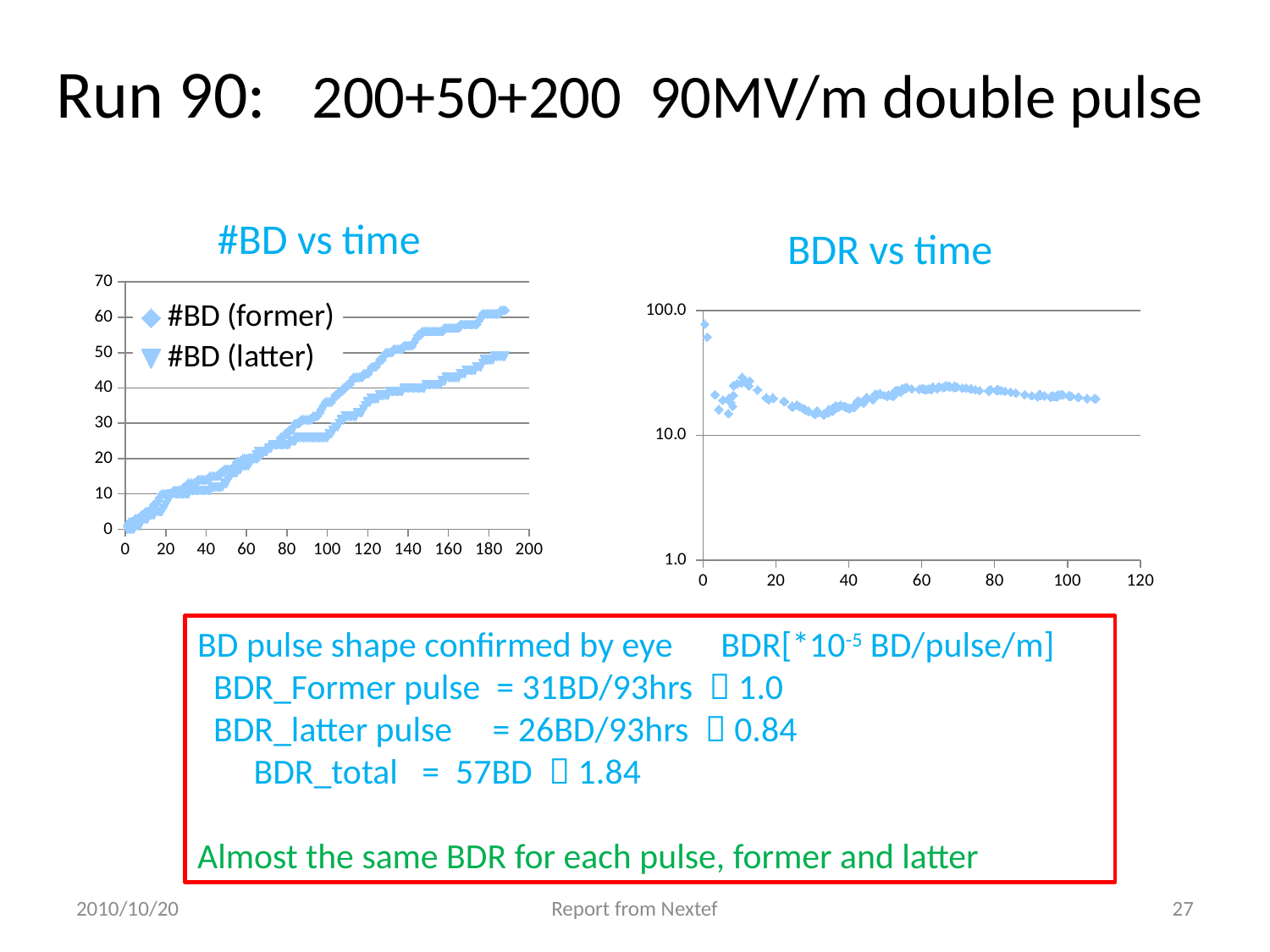
In the '#BD vs time' chart, is the value of #BD (latter) at x = 100 greater or less than 30? less In the '#BD vs time' chart, how many series does the legend list? 2 In the '#BD vs time' chart, at x = 180, which series has the larger value, #BD (former) or #BD (latter)? #BD (former) In the '#BD vs time' chart, do the #BD values rise or fall as time increases along the x axis? rise In the 'BDR vs time' chart, is the value at x = 100 greater or less than 10.0? greater What kind of chart is the 'BDR vs time' chart? scatter chart What kind of chart is the '#BD vs time' chart? scatter chart In the '#BD vs time' chart, what is the maximum value shown on the y axis? 70 In the 'BDR vs time' chart, does the BDR value rise or fall over the first 20 units of the x axis? fall In the 'BDR vs time' chart, is the first point (near x = 0) greater or less than 10.0? greater In the '#BD vs time' chart, what are the names of the two series in the legend? #BD (former) and #BD (latter)